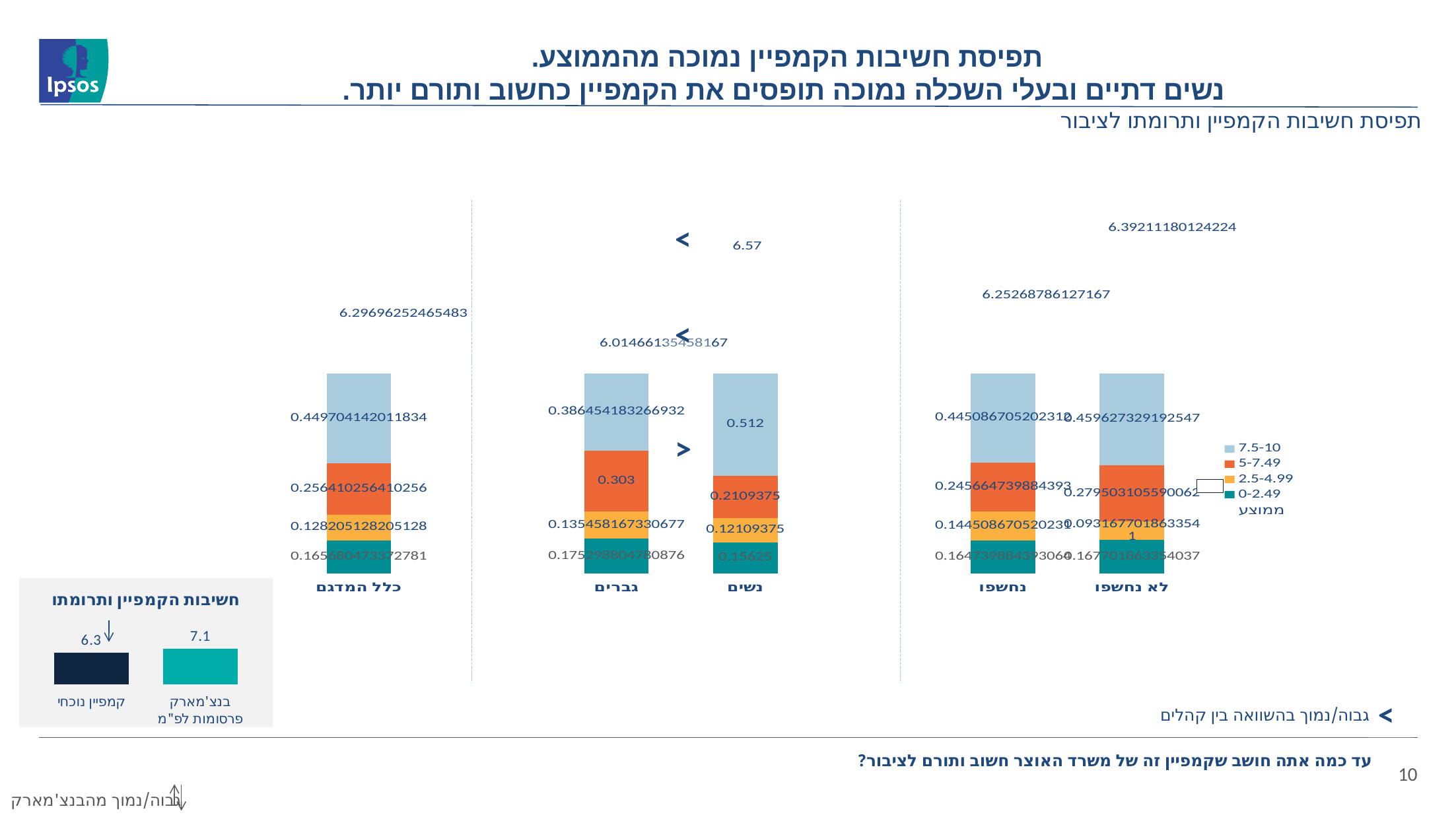
In the main stacked bar chart, which group has the higher average, גברים or נשים? נשים In the main stacked bar chart, what is the value of the 7.5-10 segment for נשים? 0.512 In the main stacked bar chart, what is the ממוצע (average) shown for גברים? 6.01466135458167 How many categories (bars) are shown in the main stacked bar chart? 5 In the main stacked bar chart, what is the value of the 0-2.49 segment for נשים? 0.15625 In the main stacked bar chart, which group has the larger 7.5-10 segment, גברים or נשים? נשים In the main stacked bar chart, what is the value of the 5-7.49 segment for גברים? 0.303 How many entries does the legend of the main chart list? 5 In the small chart at the bottom left titled חשיבות הקמפיין ותרומתו, what is the value for קמפיין נוכחי? 6.3 In the main stacked bar chart, what is the value of the 2.5-4.99 segment for נשים? 0.12109375 In the main stacked bar chart, what is the ממוצע (average) shown for נשים? 6.57 In the small chart at the bottom left titled חשיבות הקמפיין ותרומתו, what is the difference between the בנצ'מארק value and the קמפיין נוכחי value? 0.8